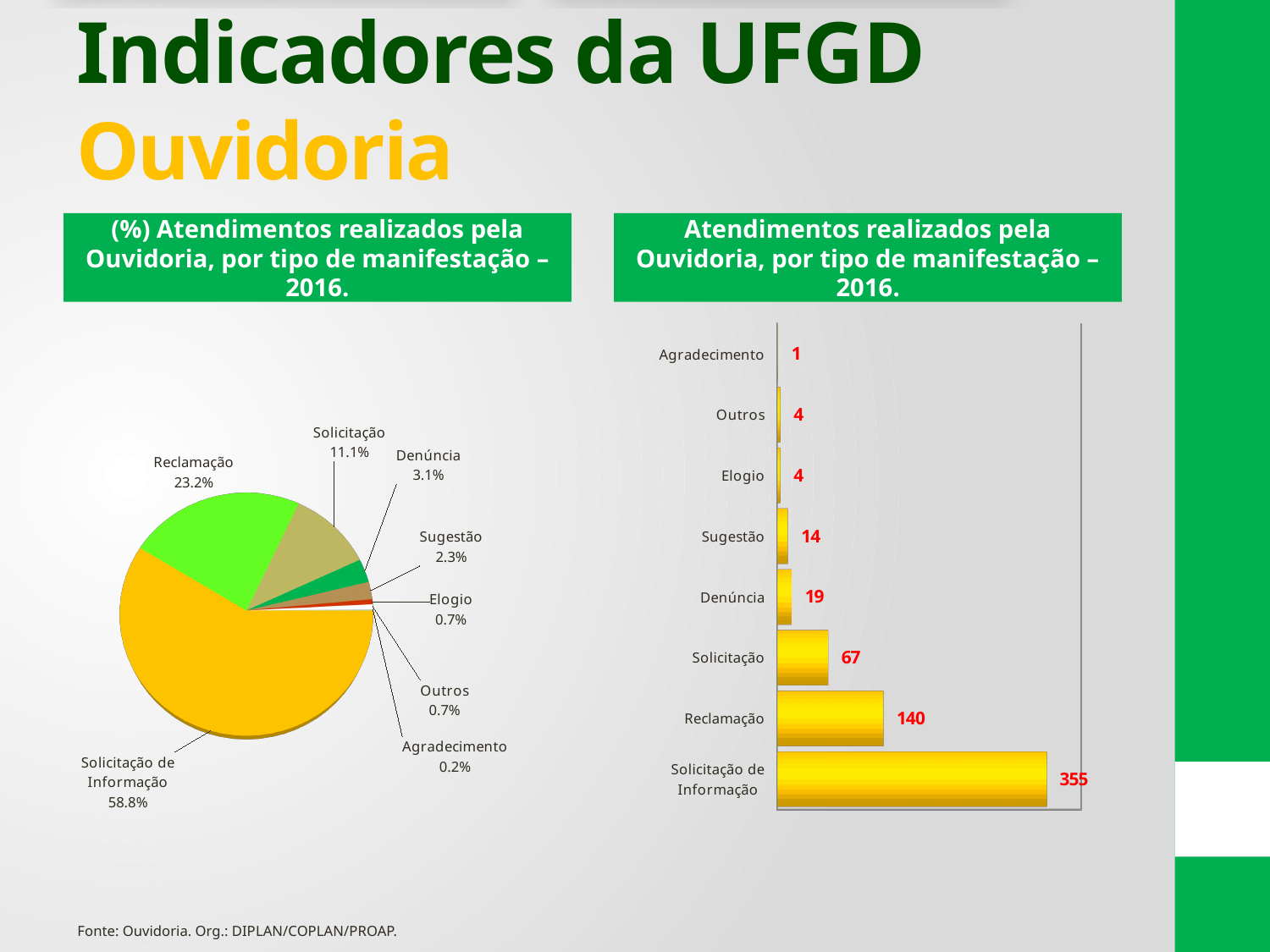
What type of chart is on the left side of the slide? Pie chart In the bar chart on the right, which is larger, Solicitação or Sugestão? Solicitação In the bar chart on the right, which category has the lowest value? Agradecimento In the pie chart on the left, what percentage is shown for Solicitação? 11.1% What type of chart is on the right side of the slide? Bar chart In the bar chart on the right, which category has the highest value? Solicitação de Informação In the pie chart on the left, what is the difference between the shares of Reclamação and Denúncia? 20.1% In the pie chart on the left, what share does Solicitação de Informação have? 58.8% In the bar chart on the right, what is the value for Reclamação? 140 In the bar chart on the right, what is the value for Denúncia? 19 How many categories are shown in the bar chart on the right? 8 In the bar chart on the right, what is the difference between Solicitação de Informação and Reclamação? 215